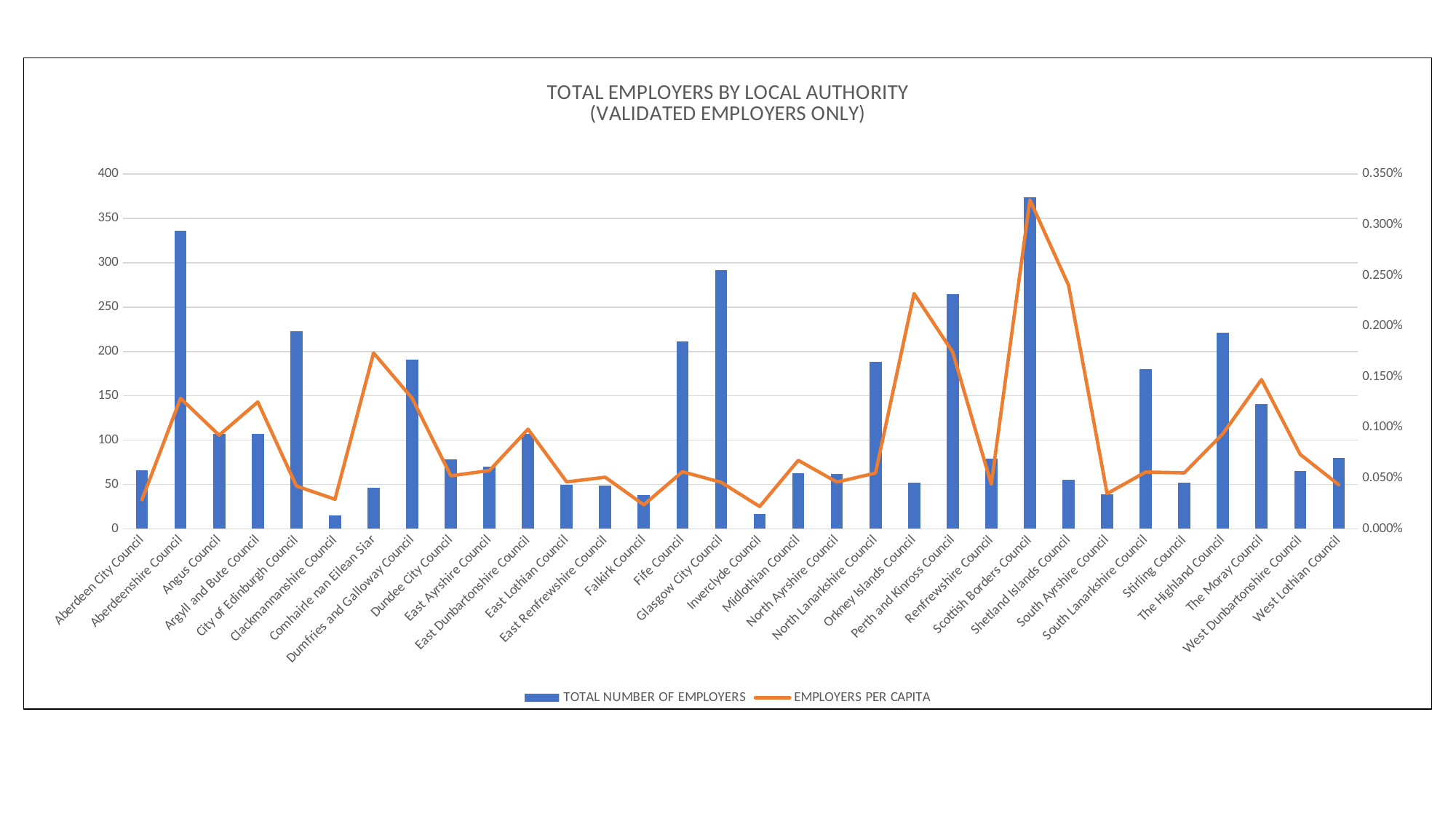
What is the title of the chart? TOTAL EMPLOYERS BY LOCAL AUTHORITY (VALIDATED EMPLOYERS ONLY) How many local authorities are shown on the x axis? 32 Is the total number of employers for Aberdeenshire Council greater or less than 300? greater Which local authority has the highest total number of employers? Scottish Borders Council Is the total number of employers for Clackmannanshire Council greater or less than 50? less Which local authority has the highest employers per capita? Scottish Borders Council Which has a higher total number of employers, Fife Council or Perth and Kinross Council? Perth and Kinross Council Which series is drawn as an orange line? EMPLOYERS PER CAPITA Is the total number of employers for Glasgow City Council greater or less than 250? greater How many series does the legend list? 2 Which has a higher total number of employers, Aberdeenshire Council or Glasgow City Council? Aberdeenshire Council